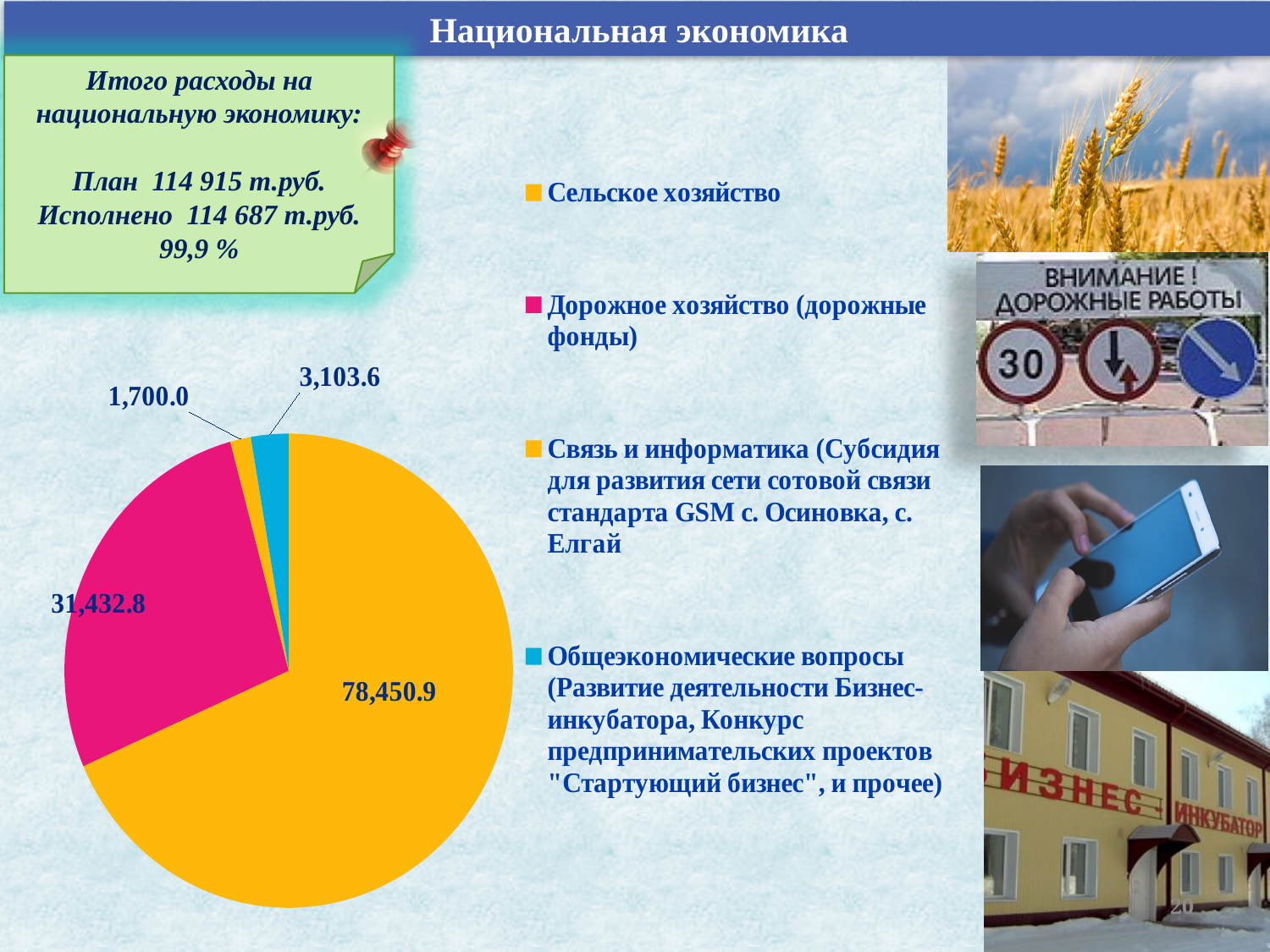
What is the value for Общеэкономические вопросы in the pie chart? 3,103.6 Which category has the largest slice in the pie chart? Сельское хозяйство How many entries does the legend of the pie chart list? 4 Which category has the smallest slice in the pie chart? Связь и информатика What is the value for Дорожное хозяйство (дорожные фонды) in the pie chart? 31,432.8 What colour is the slice for Дорожное хозяйство (дорожные фонды) in the pie chart? pink What is the value for Сельское хозяйство in the pie chart? 78,450.9 How many slices does the pie chart have? 4 What is the difference between the values for Сельское хозяйство and Дорожное хозяйство? 47,018.1 Which is larger: the value for Общеэкономические вопросы or the value for Связь и информатика? Общеэкономические вопросы What type of chart is shown on the slide? pie chart What is the value for Связь и информатика in the pie chart? 1,700.0